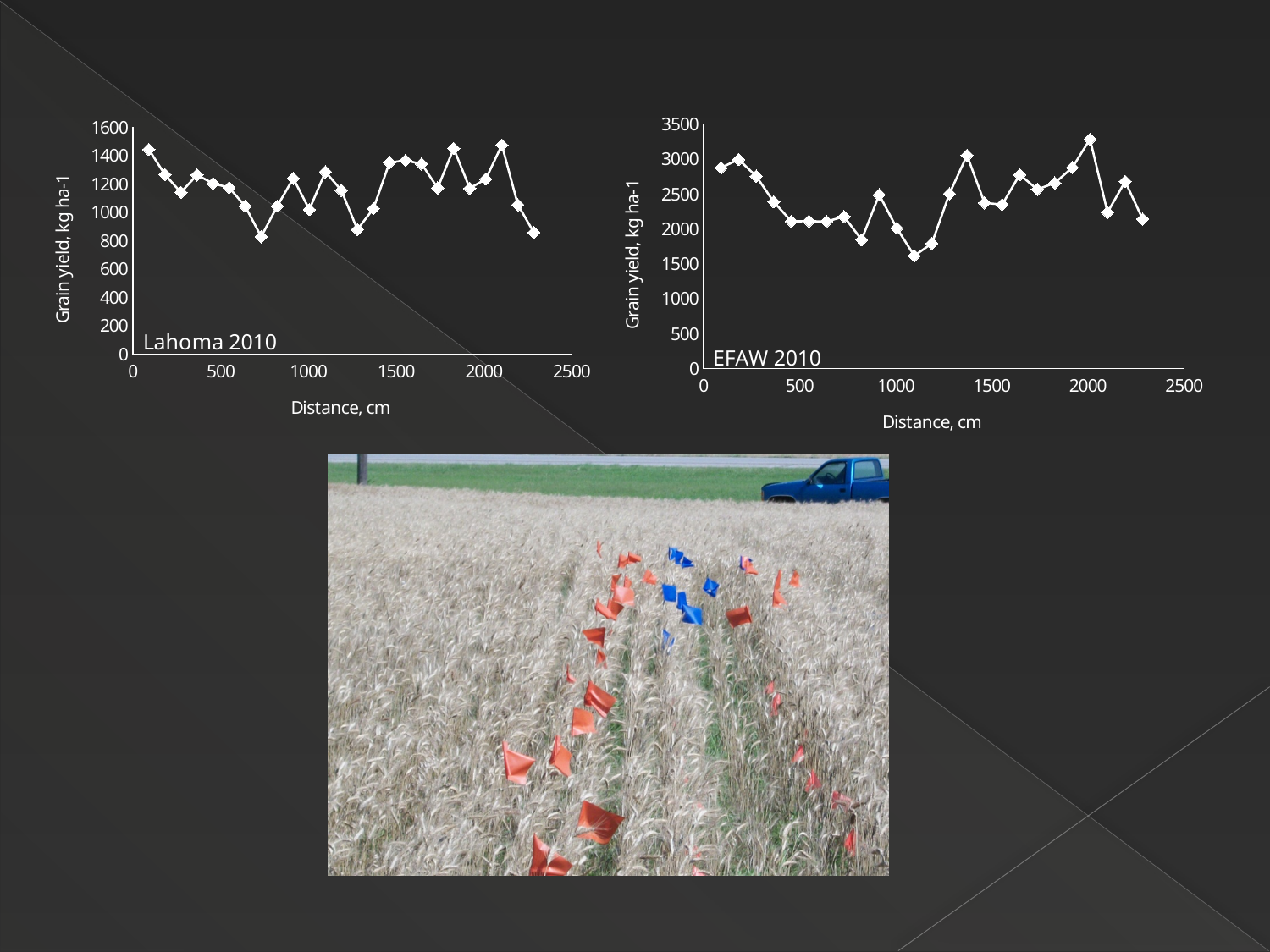
In the Lahoma 2010 chart, is the lowest grain yield value greater or less than 1000? less In the EFAW 2010 chart, is the lowest grain yield value greater or less than 2000? less In the EFAW 2010 chart, which is larger: the grain yield at the first plotted point or at the last plotted point? the first plotted point In the EFAW 2010 chart, is the grain yield at the first plotted point greater or less than 2500? greater In the EFAW 2010 chart, what is the label of the x axis? Distance, cm What kind of chart is the EFAW 2010 chart? line chart What kind of chart is the Lahoma 2010 chart? line chart In the Lahoma 2010 chart, which is larger: the grain yield at the first plotted point or at the last plotted point? the first plotted point In the Lahoma 2010 chart, what is the label of the y axis? Grain yield, kg ha-1